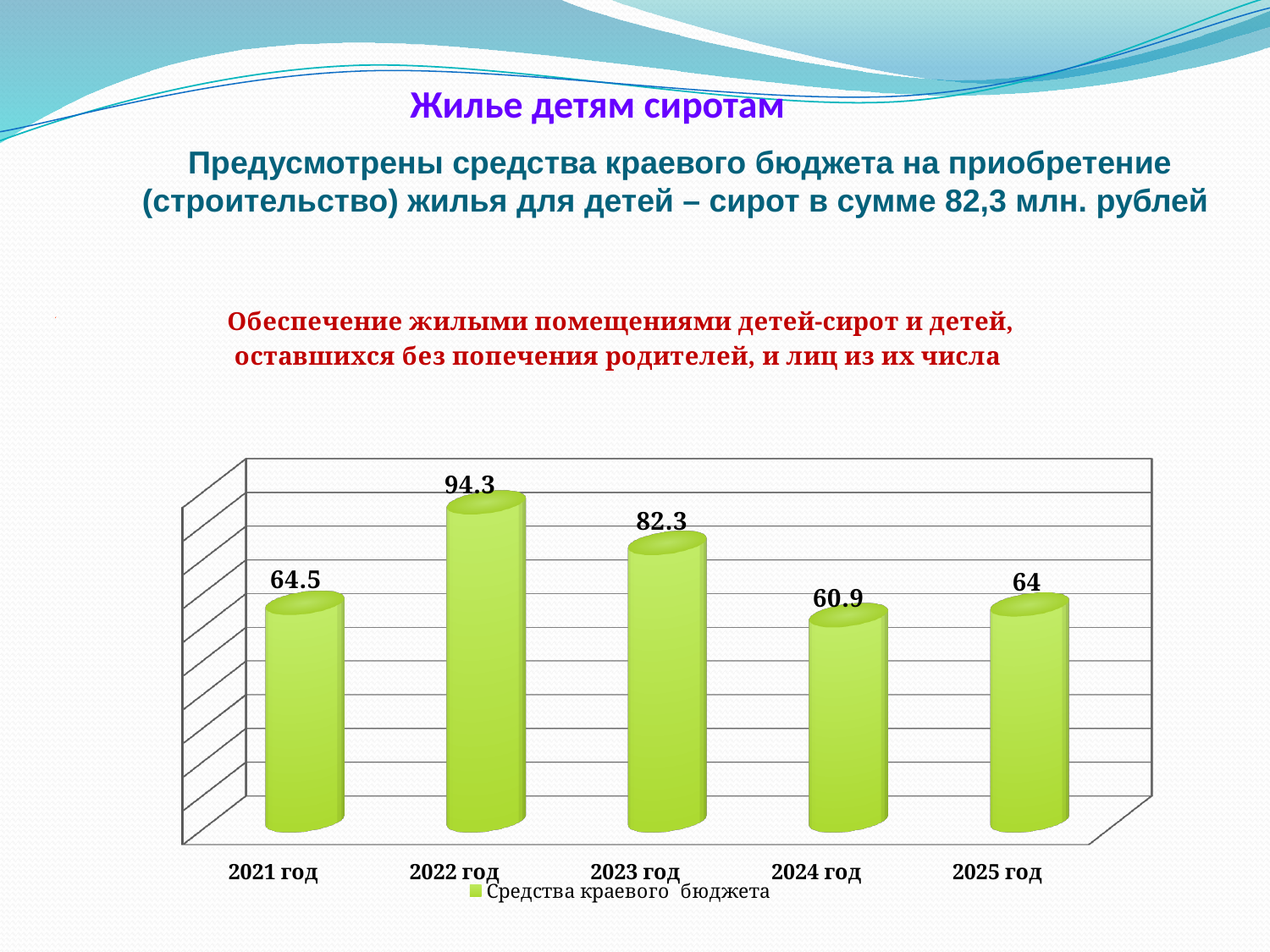
What is the legend entry for the series shown? Средства краевого бюджета Which year has the highest value? 2022 год Which year has the lowest value? 2024 год What is the value for 2022 год? 94.3 Which is larger, the value for 2021 год or the value for 2023 год? 2023 год What is the value for 2021 год? 64.5 What is the value for 2024 год? 60.9 What is the value for 2025 год? 64 What kind of chart is shown on the slide? bar chart How many years are shown on the x axis? 5 How many series does the legend list? 1 What is the difference between the values for 2022 год and 2023 год? 12